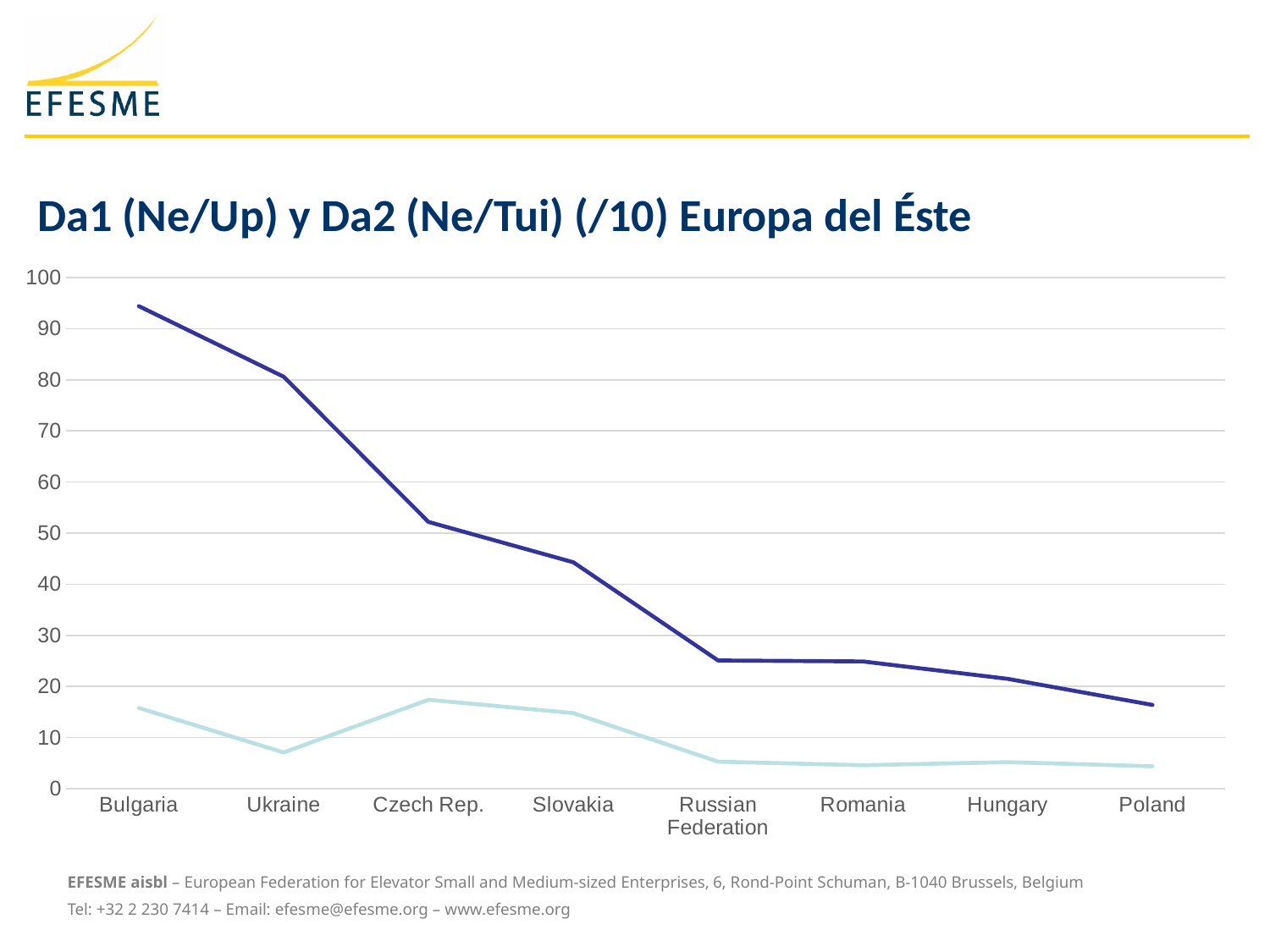
Is the value of the light blue line for Czech Rep. greater or less than 10? greater Is the value of the dark blue line for Bulgaria greater or less than 90? greater How many countries are shown on the x axis of the chart? 8 Is the value of the dark blue line for Slovakia greater or less than 50? less Does the dark blue line generally rise or fall from Bulgaria to Poland? fall For which country is the dark blue line highest? Bulgaria How many lines are plotted on the chart? 2 What is the title of the chart? Da1 (Ne/Up) y Da2 (Ne/Tui) (/10) Europa del Éste On the dark blue line, which is larger: the value for Czech Rep. or the value for Slovakia? Czech Rep. What kind of chart is shown on the slide? line chart For which country is the dark blue line lowest? Poland